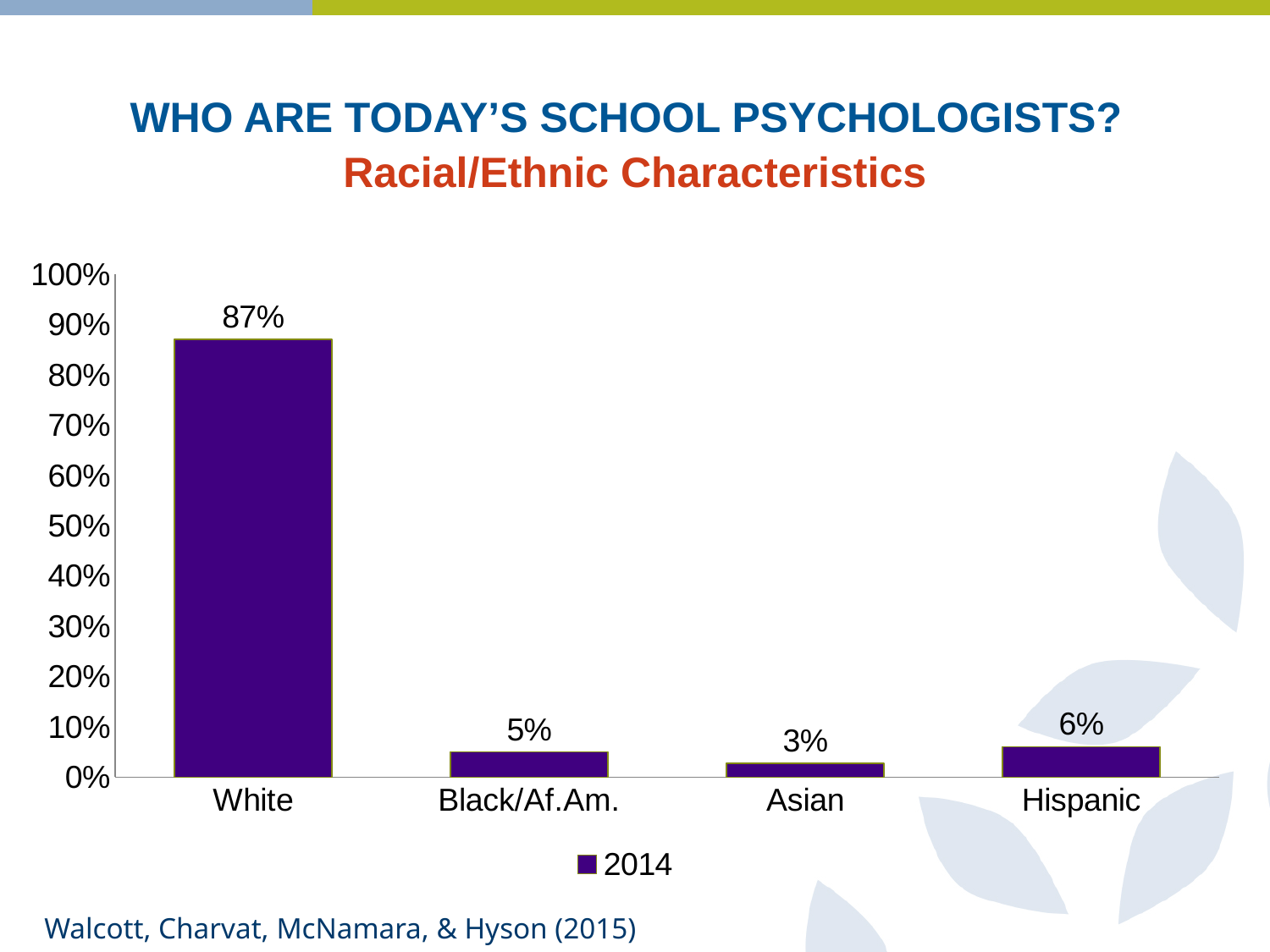
How many series does the legend list? 1 Which is larger, the value for Hispanic or the value for Black/Af.Am.? Hispanic What is the difference between the White and Hispanic values? 81% What kind of chart is shown on the slide? Bar chart What is the value shown for Asian? 3% Which racial/ethnic category has the highest value? White What is the value shown for Black/Af.Am.? 5% How many racial/ethnic categories are shown on the chart? 4 Which racial/ethnic category has the lowest value? Asian What year does the legend entry refer to? 2014 What percentage of school psychologists are White according to the chart? 87% What is the value shown for Hispanic? 6%